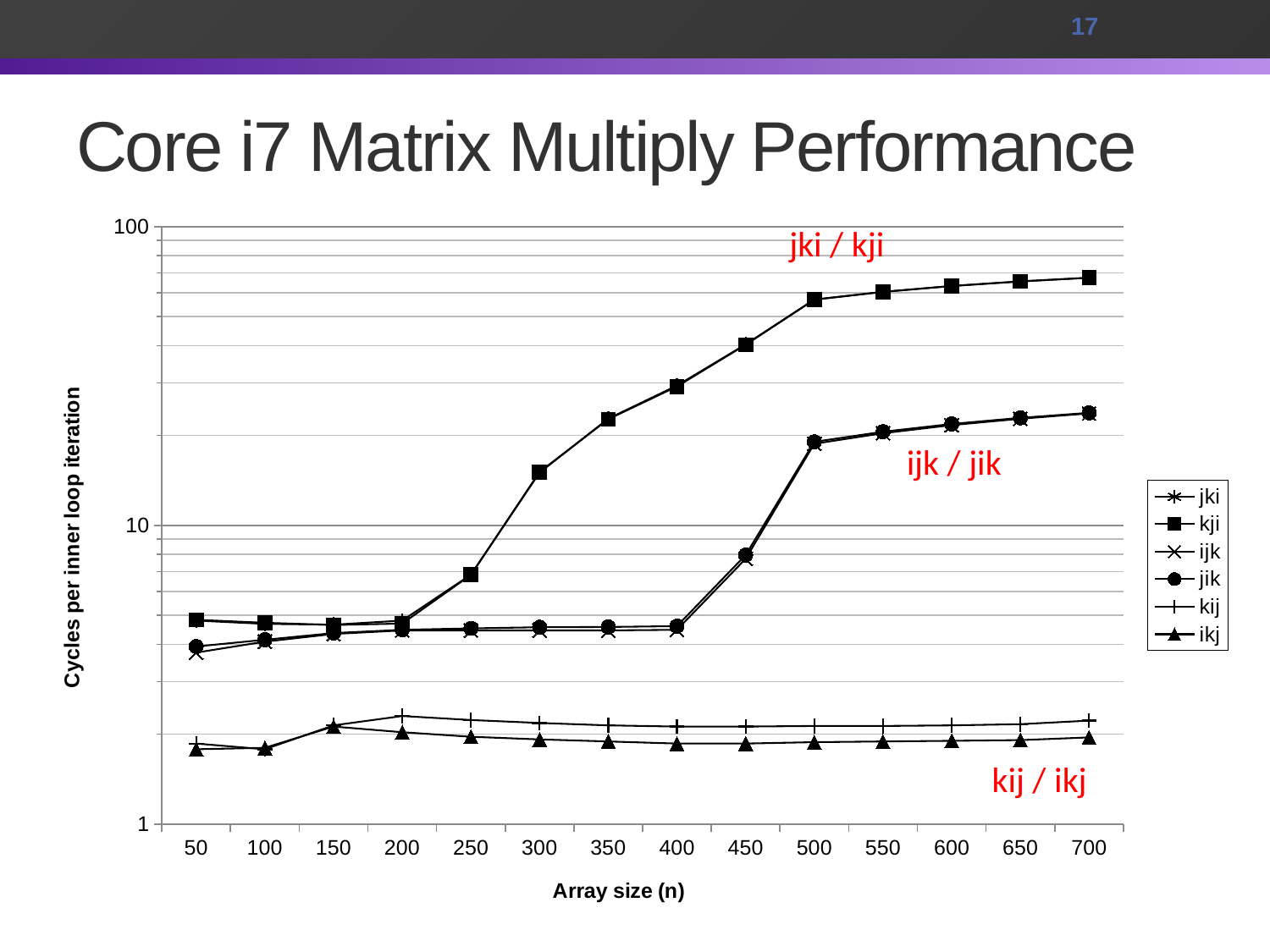
What kind of chart is shown on the slide? line chart Which series has the lowest value at array size 700? ikj Is the value for ikj at array size 700 greater or less than 10? less At array size 200, which is larger, the value for kij or the value for ikj? kij At array size 500, which is larger, the value for kji or the value for jik? kji Is the value for kji at array size 700 greater or less than 10? greater What is the title of the chart? Core i7 Matrix Multiply Performance How many series does the legend list? 6 Does the kji series rise or fall as the array size increases from 200 to 500? rise Is the value for jik at array size 400 greater or less than 10? less How many array sizes are plotted along the x axis? 14 What is the label of the y axis? Cycles per inner loop iteration